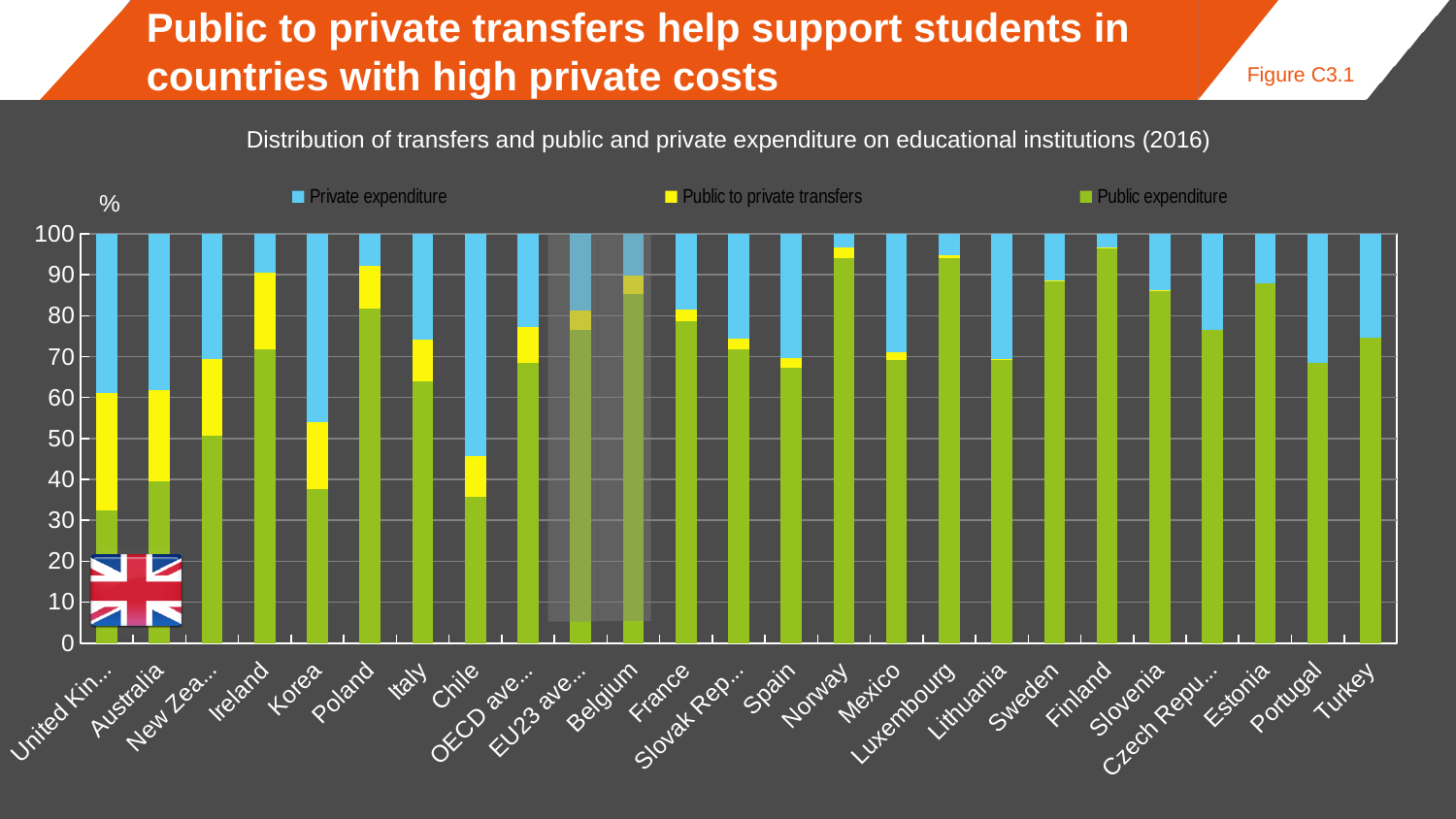
What is the subtitle describing the chart's content? Distribution of transfers and public and private expenditure on educational institutions (2016) How many series does the legend list? 3 Is the Public expenditure value for Sweden greater or less than 80? greater What kind of chart is shown on the slide? Stacked bar chart Is the Public expenditure value for Ireland greater or less than 60? greater How many countries or groups are shown along the x axis? 25 Is the Public expenditure value for Poland greater or less than 70? greater Which colour represents Public to private transfers in the chart? Yellow